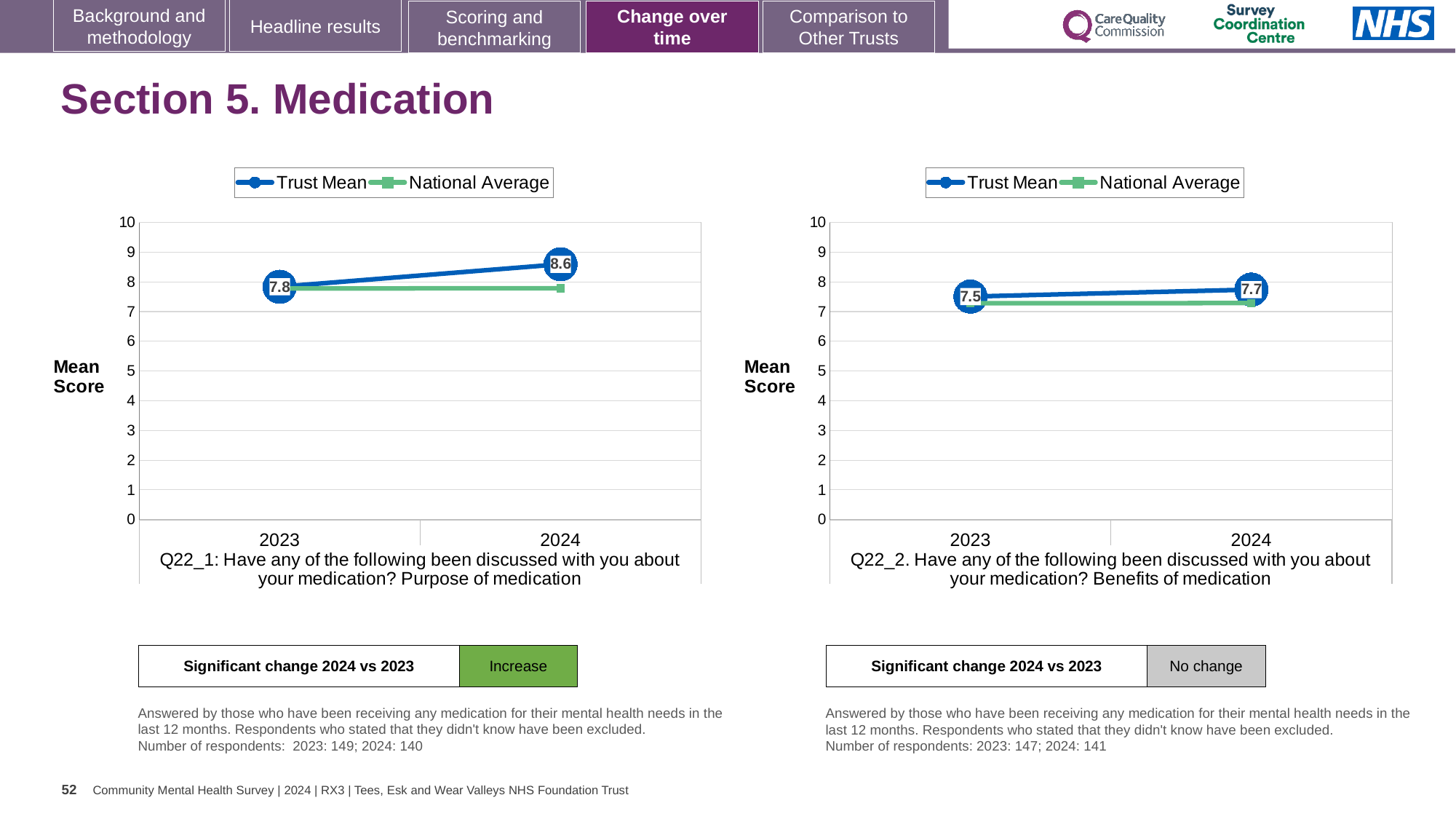
How many series does the legend of the left chart (Q22_1: Purpose of medication) list? 2 How many years are shown on the x axis of the right chart (Q22_2: Benefits of medication)? 2 In the left chart (Q22_1: Purpose of medication), does the Trust Mean rise or fall from 2023 to 2024? rise What kind of chart is the right chart (Q22_2: Benefits of medication)? line chart In the left chart (Q22_1: Purpose of medication), which is larger in 2024, the Trust Mean or the National Average? Trust Mean In the left chart (Q22_1: Purpose of medication), what is the Trust Mean for 2023? 7.8 In the right chart (Q22_2: Benefits of medication), is the National Average for 2024 greater or less than 8? less In the left chart (Q22_1: Purpose of medication), by how much did the Trust Mean change from 2023 to 2024? 0.8 In the right chart (Q22_2: Benefits of medication), what is the difference between the Trust Mean in 2024 and in 2023? 0.2 In the left chart (Q22_1: Purpose of medication), what is the Trust Mean for 2024? 8.6 In the right chart (Q22_2: Benefits of medication), what is the Trust Mean for 2024? 7.7 In the right chart (Q22_2: Benefits of medication), what is the Trust Mean for 2023? 7.5